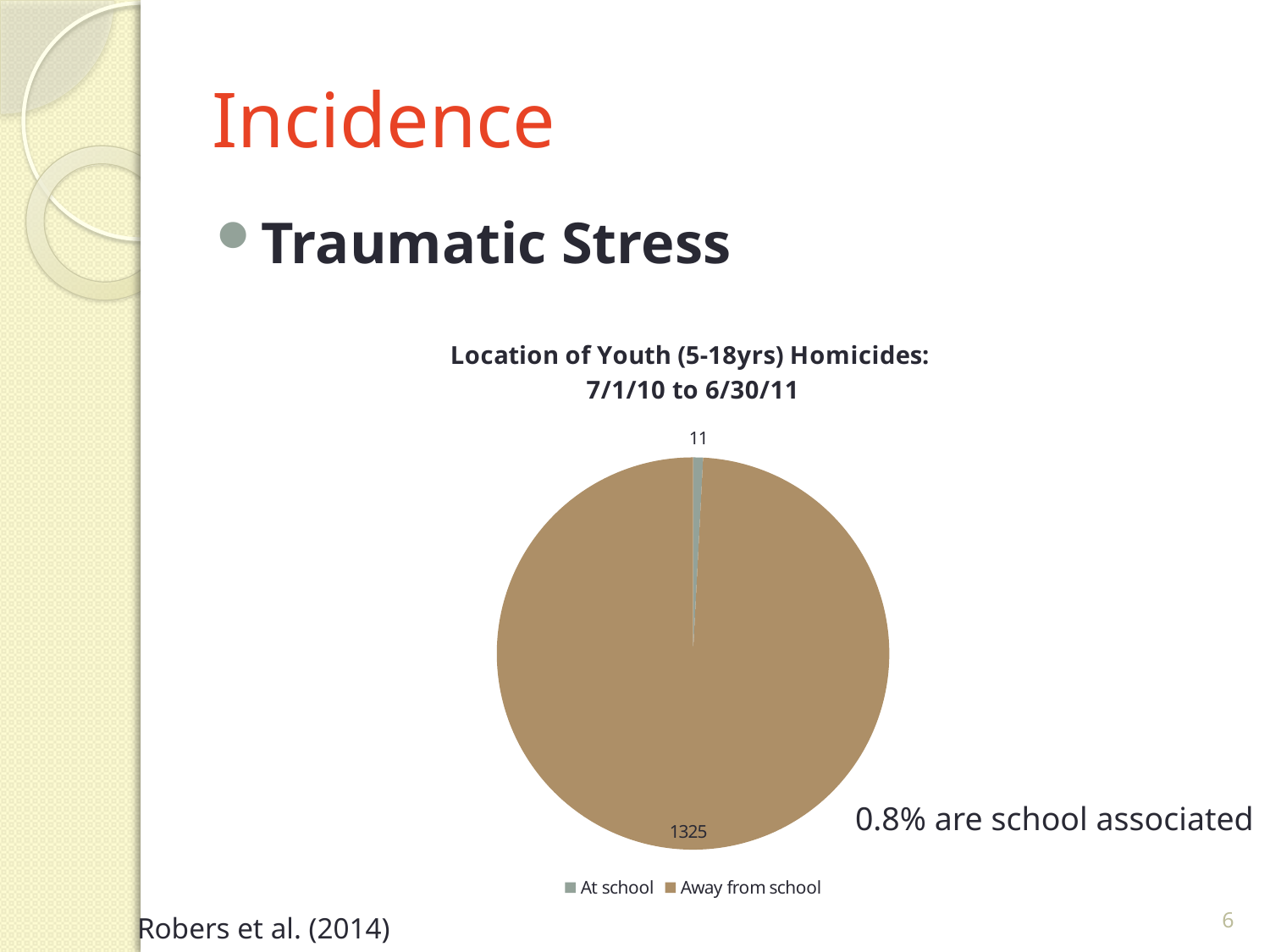
How many categories does the pie chart show? 2 Which is larger, the number of homicides at school or away from school? Away from school What is the title of the chart? Location of Youth (5-18yrs) Homicides: 7/1/10 to 6/30/11 How many entries does the legend list? 2 How many youth homicides occurred away from school? 1325 What is the difference between the number of homicides away from school and at school? 1314 How many youth homicides occurred at school? 11 Which category has the smallest slice of the pie? At school What type of chart is shown on the slide? pie chart What is the total number of youth homicides shown in the pie chart? 1336 Which category has the largest slice of the pie? Away from school According to the text next to the chart, what percentage of youth homicides are school associated? 0.8%